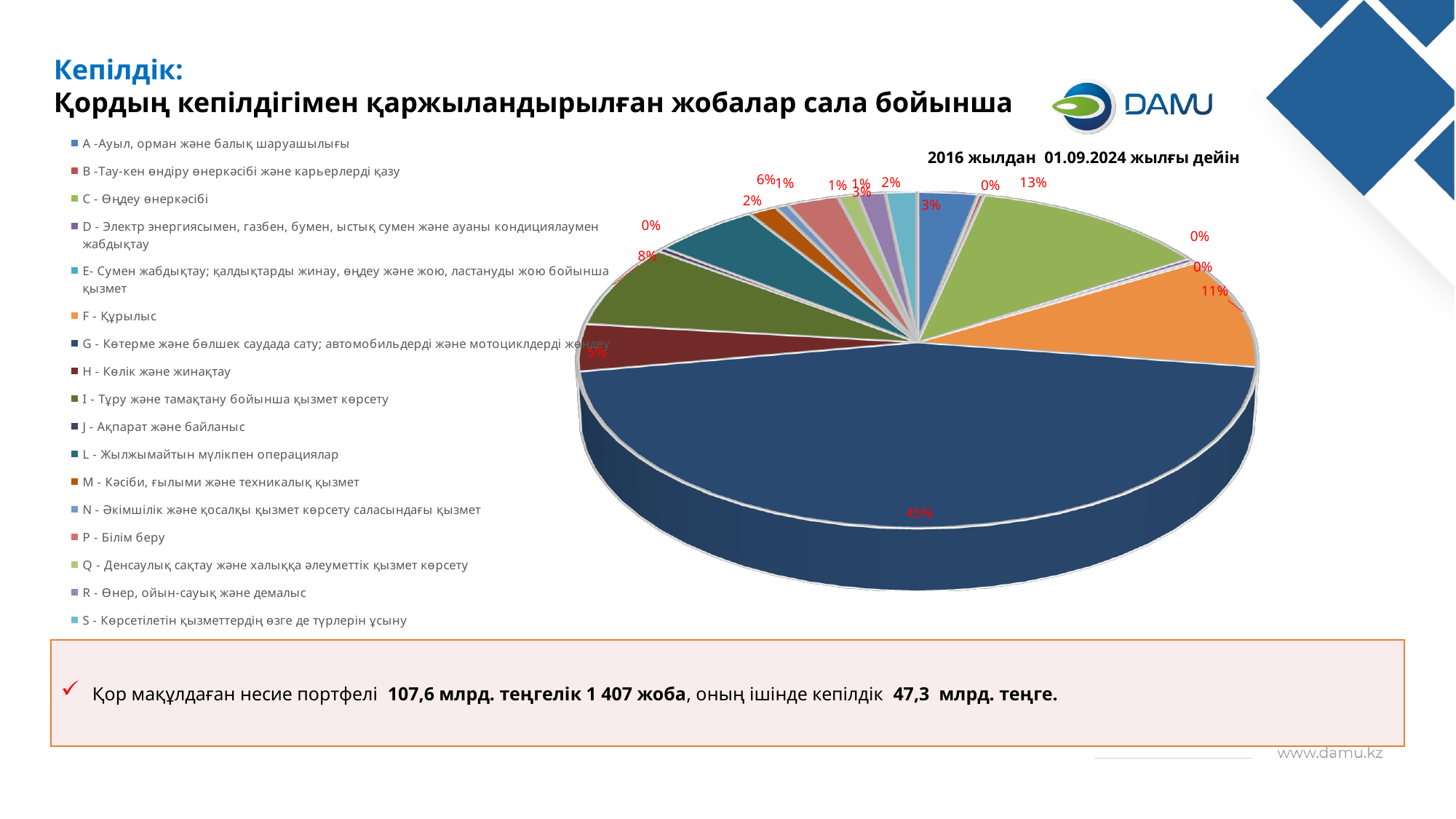
What share of the pie does category F (Құрылыс) have? 11% What period does the chart cover, according to the label above the pie? 2016 жылдан 01.09.2024 жылғы дейін How many categories does the legend of the pie chart list? 17 What share of the pie does category G (Көтерме және бөлшек саудада сату) have? 45% Which category has the largest share of the pie? G - Көтерме және бөлшек саудада сату; автомобильдерді және мотоциклдерді жөндеу What share of the pie does category H (Көлік және жинақтау) have? 5% What is the title of the chart on the slide? Қордың кепілдігімен қаржыландырылған жобалар сала бойынша What is the difference in percentage points between the share of category G and the share of category C? 32% Which is larger: the share of category C (Өңдеу өнеркәсібі) or category F (Құрылыс)? C - Өңдеу өнеркәсібі What kind of chart is shown on the slide? Pie chart